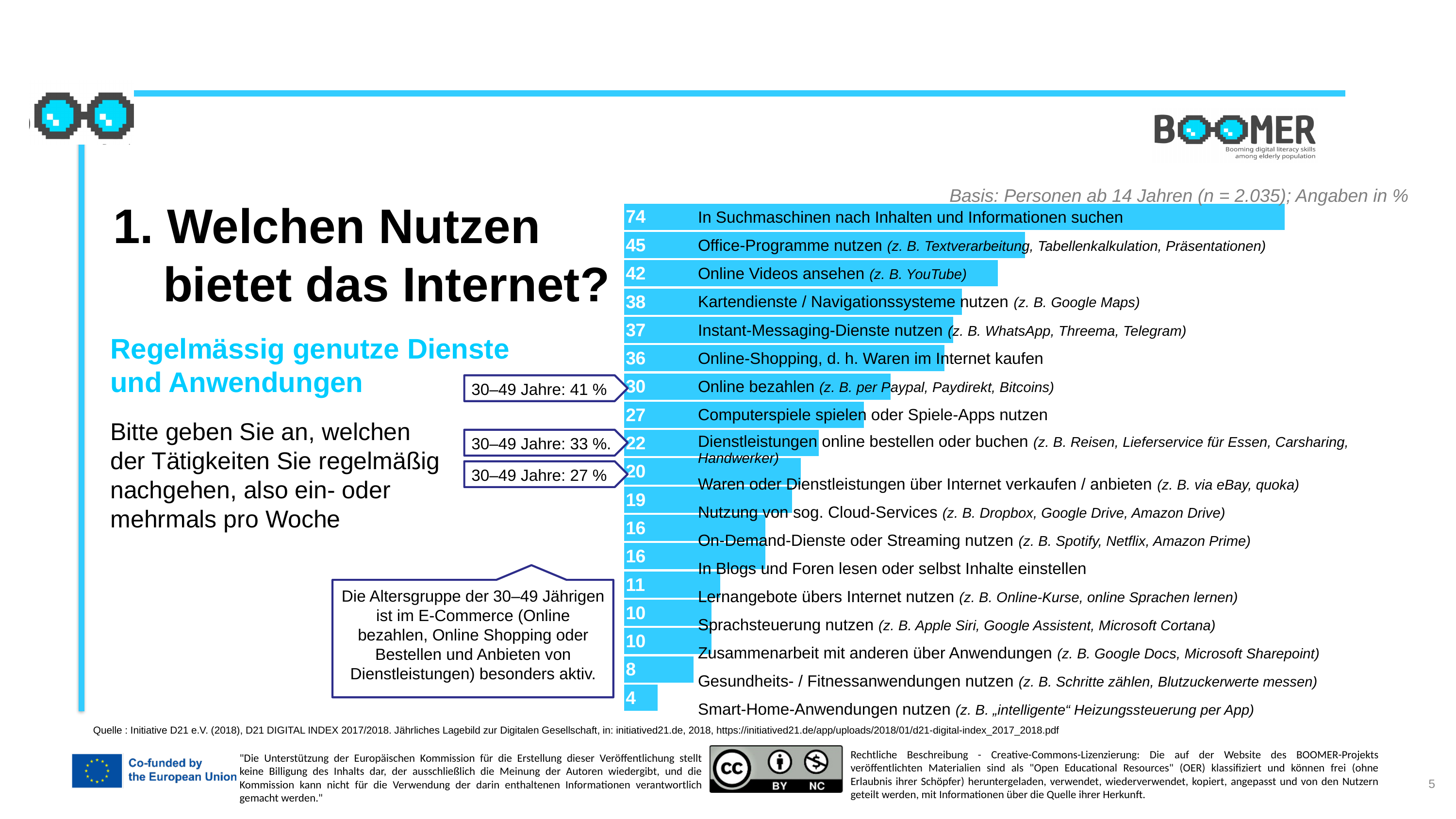
Which activity has the lowest value in the chart? Smart-Home-Anwendungen nutzen How many activities (bars) are shown in the chart? 18 What is the difference between the values for "Office-Programme nutzen" and "Online bezahlen"? 15 What value is shown for "Online Videos ansehen"? 42 What kind of chart is shown on the slide? Bar chart What value is shown for "In Suchmaschinen nach Inhalten und Informationen suchen"? 74 What value is shown for "Online-Shopping, d. h. Waren im Internet kaufen"? 36 Which activity has the highest value in the chart? In Suchmaschinen nach Inhalten und Informationen suchen What is the difference between the values for "Nutzung von sog. Cloud-Services" and "Gesundheits- / Fitnessanwendungen nutzen"? 11 According to the callout, what is the value for the 30–49 age group for "Online bezahlen"? 41 % What value is shown for "Smart-Home-Anwendungen nutzen"? 4 Which has a larger value: "Kartendienste / Navigationssysteme nutzen" or "Computerspiele spielen oder Spiele-Apps nutzen"? Kartendienste / Navigationssysteme nutzen